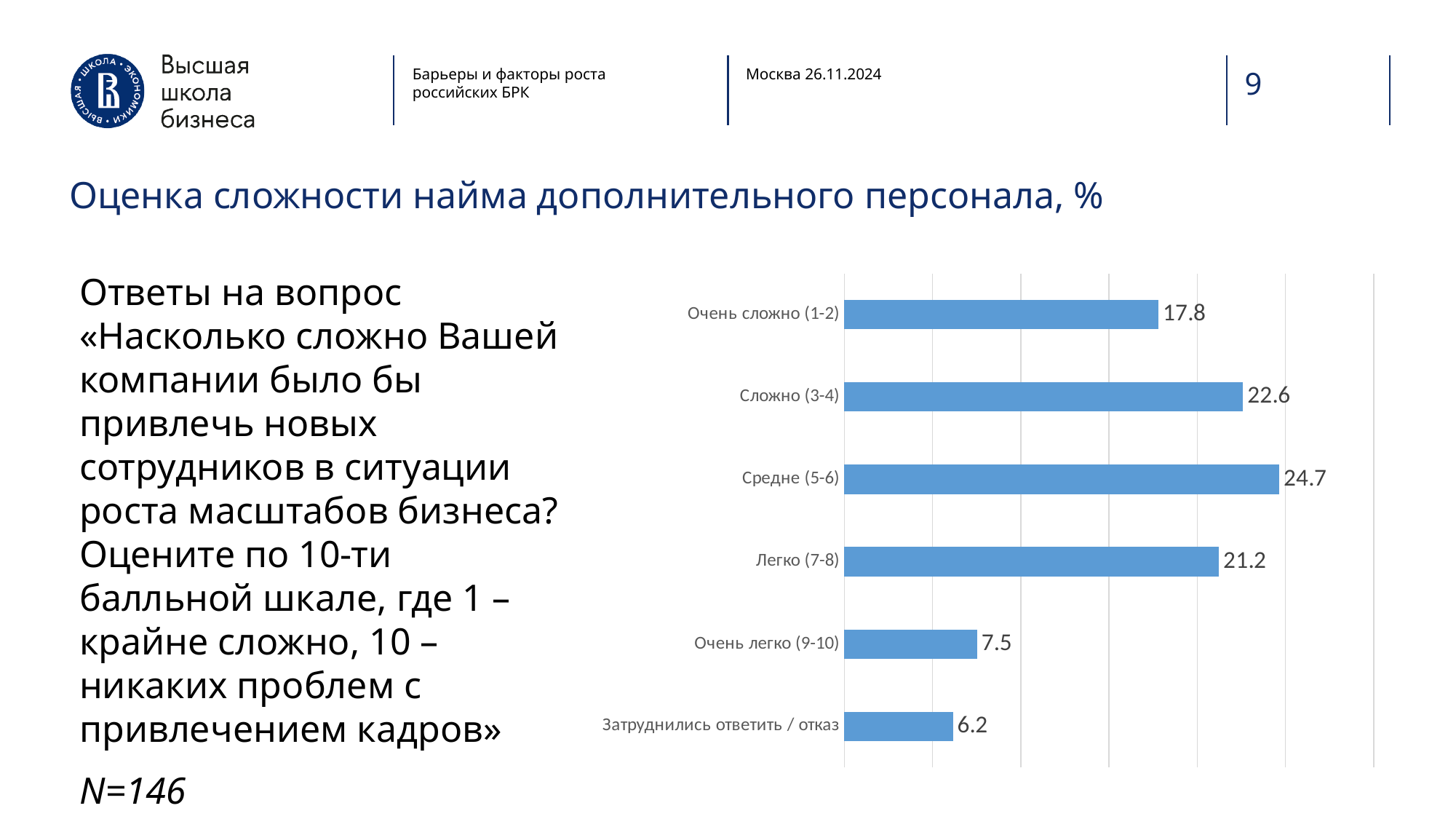
Which is larger, the value for «Сложно (3-4)» or the value for «Легко (7-8)»? Сложно (3-4) What is the sample size (N) stated on the slide? N=146 What is the value for «Очень сложно (1-2)»? 17.8 What is the difference between the values for «Средне (5-6)» and «Легко (7-8)»? 3.5 What is the difference between the values for «Очень легко (9-10)» and «Затруднились ответить / отказ»? 1.3 What is the title of the slide's chart section? Оценка сложности найма дополнительного персонала, % What is the value for «Затруднились ответить / отказ»? 6.2 What kind of chart is shown on the slide? Bar chart What is the value for «Сложно (3-4)»? 22.6 Which category has the lowest value? Затруднились ответить / отказ How many categories are shown in the chart? 6 Which category has the highest value? Средне (5-6)